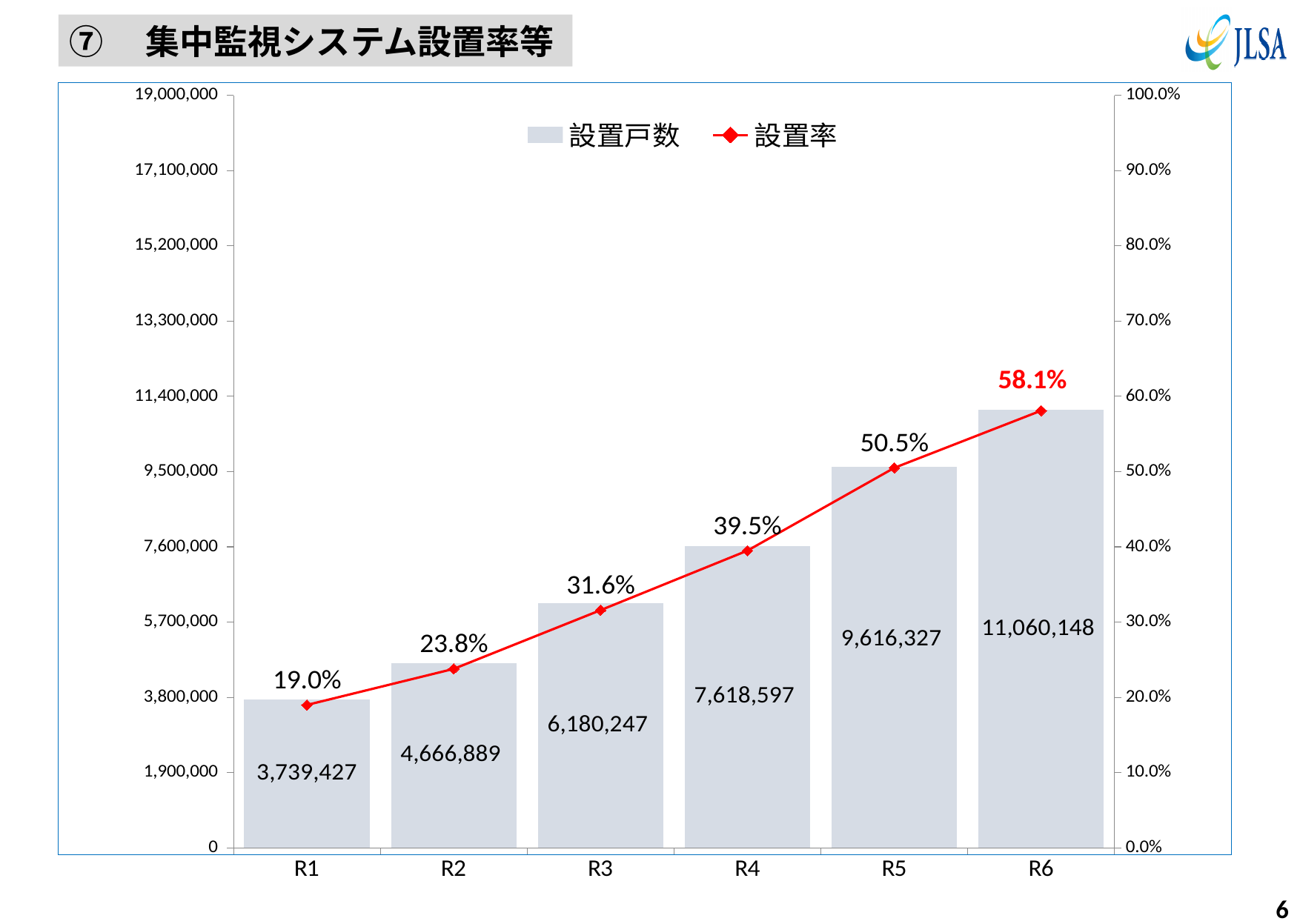
What kind of chart is this? Combined bar and line chart Does the 設置率 rise or fall from R1 to R6? Rise How many categories are shown on the x axis? 6 What is the 設置率 value for R1? 19.0% Which is larger, the 設置戸数 for R2 or for R4? R4 What is the difference in 設置率 between R4 and R3? 7.9% What is the 設置率 value for R5? 50.5% What is the 設置戸数 value for R3? 6,180,247 Which category has the highest 設置戸数? R6 Which category has the lowest 設置率? R1 How many series does the legend list? 2 What is the difference in 設置戸数 between R6 and R5? 1,443,821